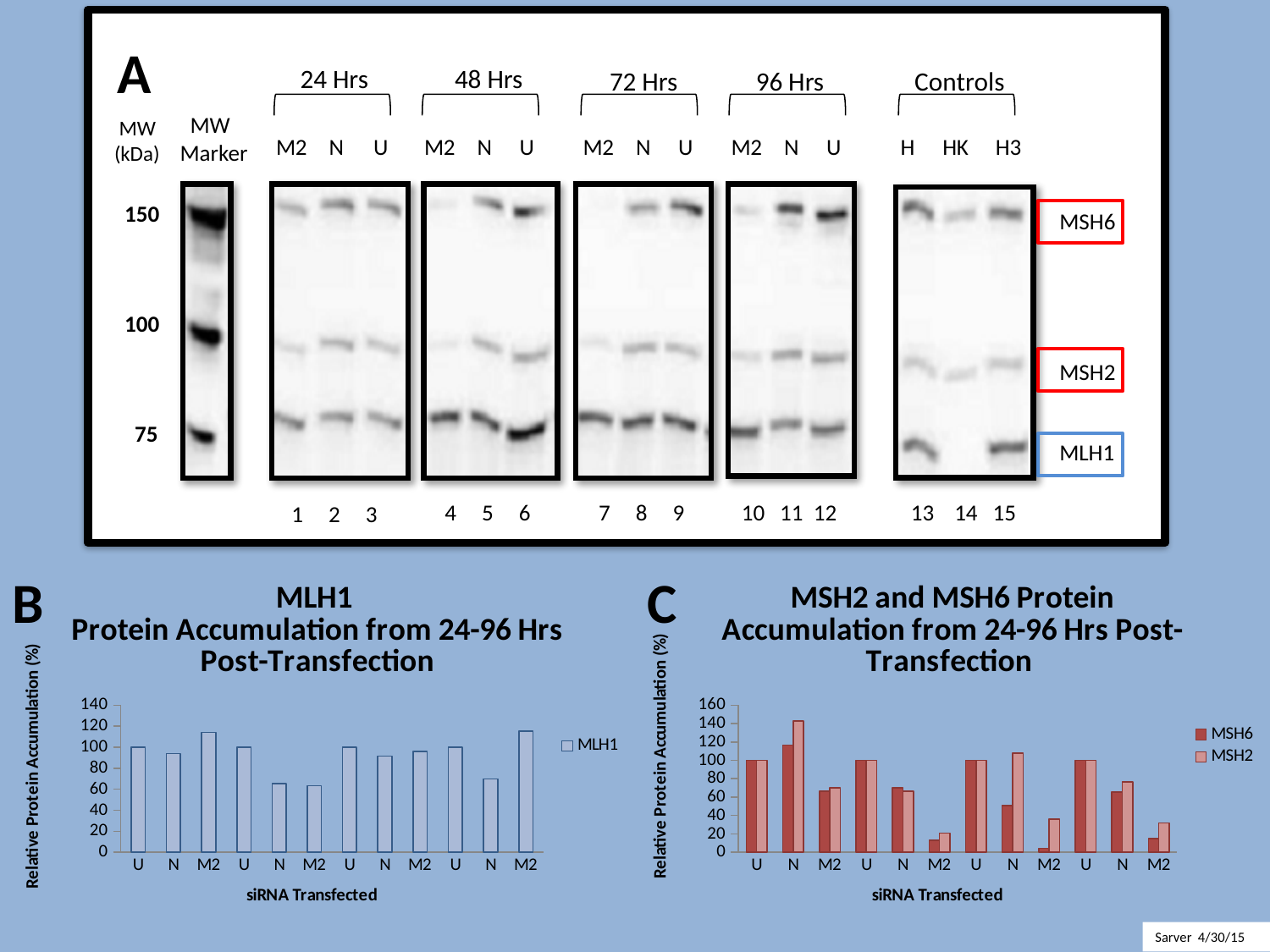
In chart B (MLH1 Protein Accumulation), is the value of the first N bar from the left greater or less than 80? greater In chart C (MSH2 and MSH6 Protein Accumulation), is the MSH2 value for the first N category from the left greater or less than 120? greater How many series does the legend of chart C (MSH2 and MSH6 Protein Accumulation) list? 2 In chart C (MSH2 and MSH6 Protein Accumulation), which category has the highest MSH2 value? the first N from the left What is the x-axis title of chart B (MLH1 Protein Accumulation)? siRNA Transfected Which series are listed in the legend of chart C (MSH2 and MSH6 Protein Accumulation)? MSH6 and MSH2 How many bars are plotted in chart B (MLH1 Protein Accumulation)? 12 What kind of chart is chart B (MLH1 Protein Accumulation from 24-96 Hrs Post-Transfection)? bar chart In chart B (MLH1 Protein Accumulation), is the value of the second N bar from the left greater or less than 80? less In chart B (MLH1 Protein Accumulation), what is the value of the first U bar from the left? 100 In chart C (MSH2 and MSH6 Protein Accumulation), at the third N category from the left, which series has the larger value, MSH6 or MSH2? MSH2